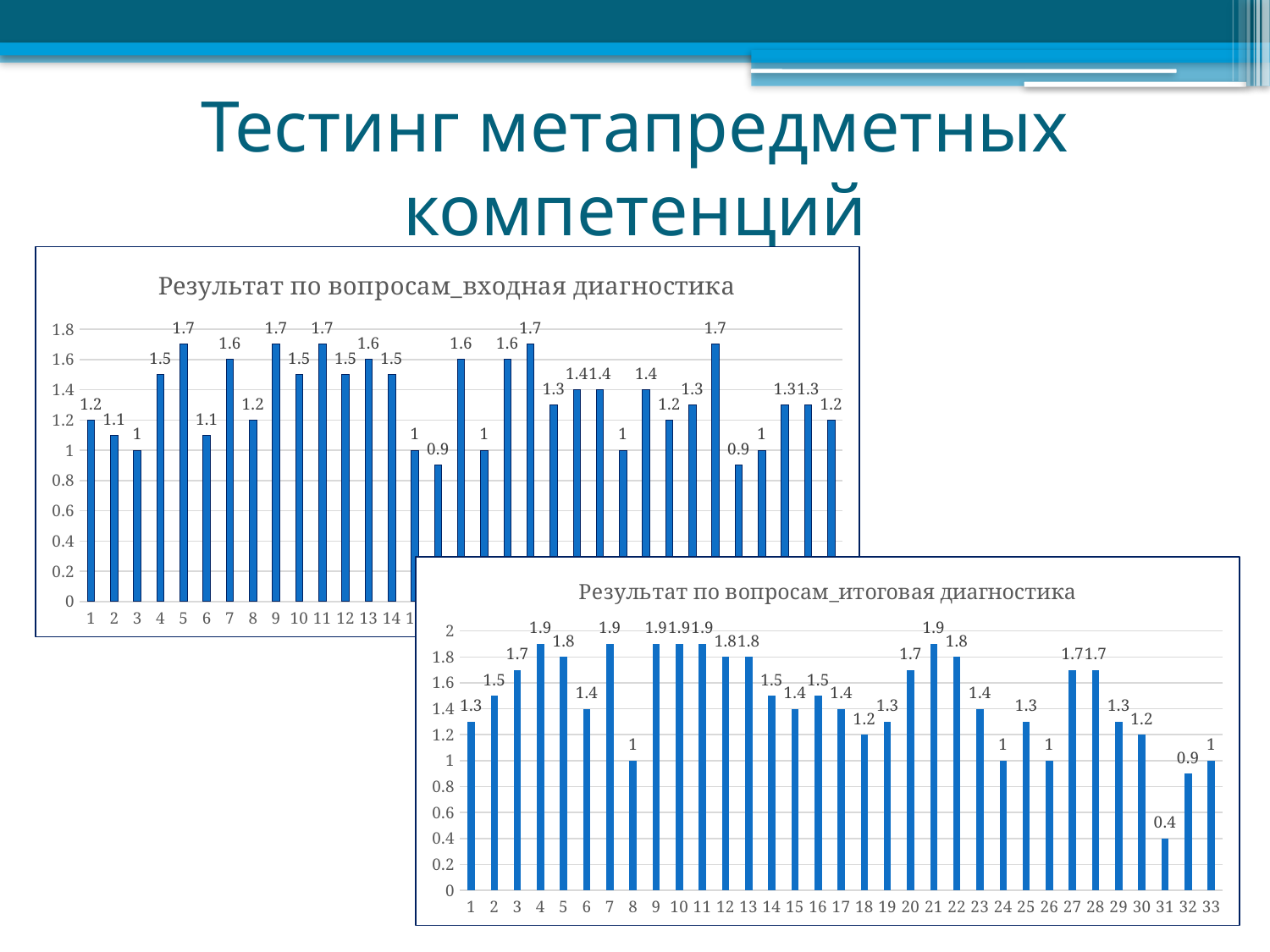
In the chart titled "Результат по вопросам_итоговая диагностика", how many questions are plotted? 33 In the chart titled "Результат по вопросам_итоговая диагностика", what is the value for question 31? 0.4 In the chart titled "Результат по вопросам_итоговая диагностика", what is the difference between the values for question 4 and question 8? 0.9 In the chart titled "Результат по вопросам_входная диагностика", what is the value for question 3? 1 What is the title of the lower chart on the slide? Результат по вопросам_итоговая диагностика In the chart titled "Результат по вопросам_итоговая диагностика", what is the value for question 20? 1.7 In the chart titled "Результат по вопросам_входная диагностика", what is the difference between the values for question 5 and question 1? 0.5 In the chart titled "Результат по вопросам_входная диагностика", what kind of chart is shown? bar chart In the chart titled "Результат по вопросам_входная диагностика", what is the value for question 5? 1.7 In the chart titled "Результат по вопросам_итоговая диагностика", which question has the lowest value? 31 In the chart titled "Результат по вопросам_итоговая диагностика", which is larger, the value for question 3 or question 6? question 3 In the chart titled "Результат по вопросам_входная диагностика", which is larger, the value for question 4 or question 6? question 4